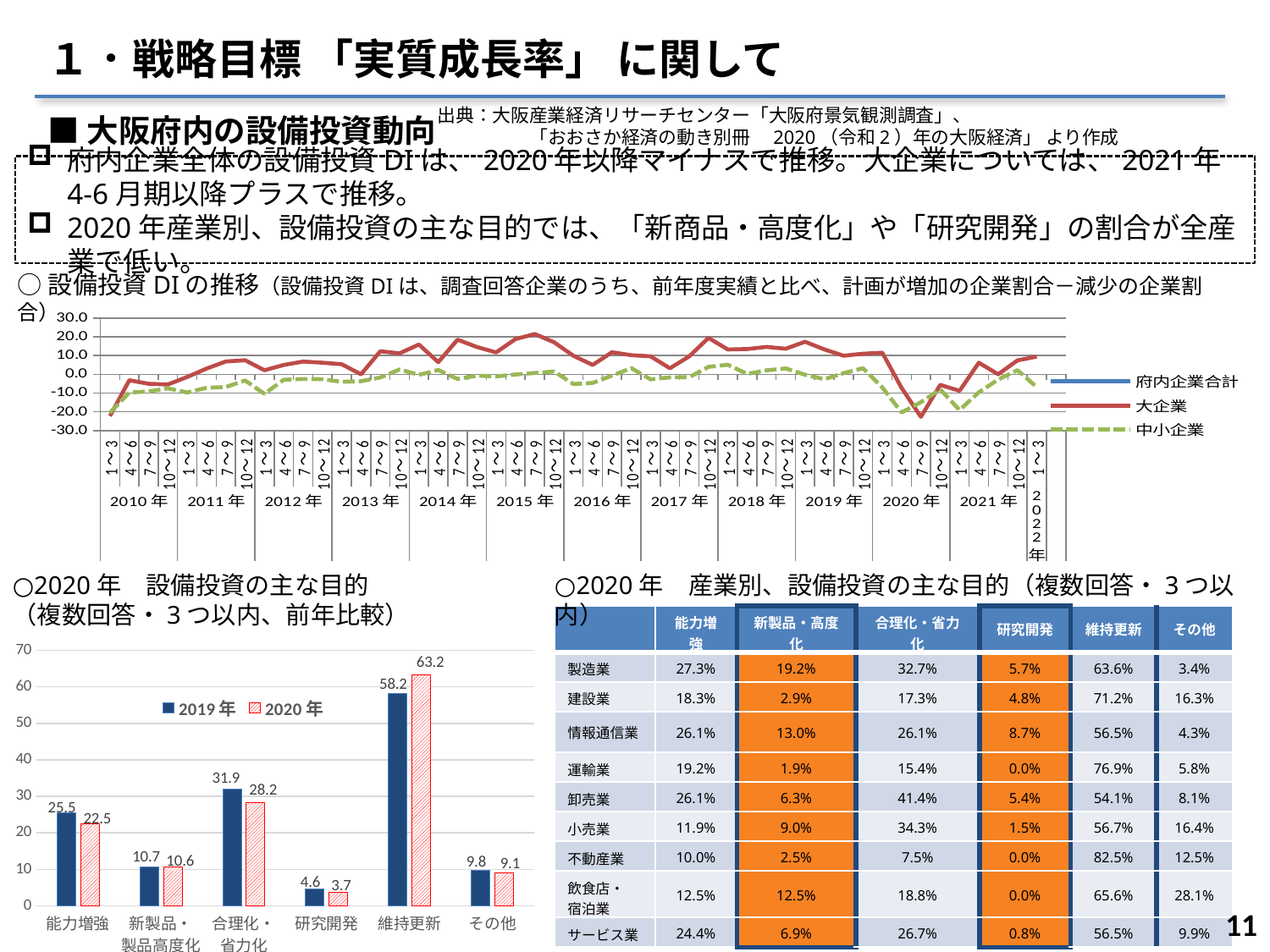
In the bar chart titled 2020年 設備投資の主な目的, what is the value for 合理化・省力化 in 2019年? 31.9 In the bar chart titled 2020年 設備投資の主な目的, how many series does the legend list? 2 In the line chart titled 設備投資DIの推移, how many series does the legend list? 3 In the line chart titled 設備投資DIの推移, is the value for 大企業 in 2020年 7~9 greater or less than 0.0? less In the bar chart titled 2020年 設備投資の主な目的, which category has the lowest value in 2019年? 研究開発 In the bar chart titled 2020年 設備投資の主な目的, which category has the highest value in 2020年? 維持更新 In the bar chart titled 2020年 設備投資の主な目的, which is larger for 能力増強: the 2019年 value or the 2020年 value? 2019年 What kind of chart is the 設備投資DIの推移 chart at the top of the slide? line chart In the bar chart titled 2020年 設備投資の主な目的, what is the difference between the 2020年 and 2019年 values for 維持更新? 5.0 In the bar chart titled 2020年 設備投資の主な目的, what is the value for 維持更新 in 2020年? 63.2 In the bar chart titled 2020年 設備投資の主な目的, what is the value for 研究開発 in 2020年? 3.7 In the bar chart titled 2020年 設備投資の主な目的, how many categories are shown on the x axis? 6